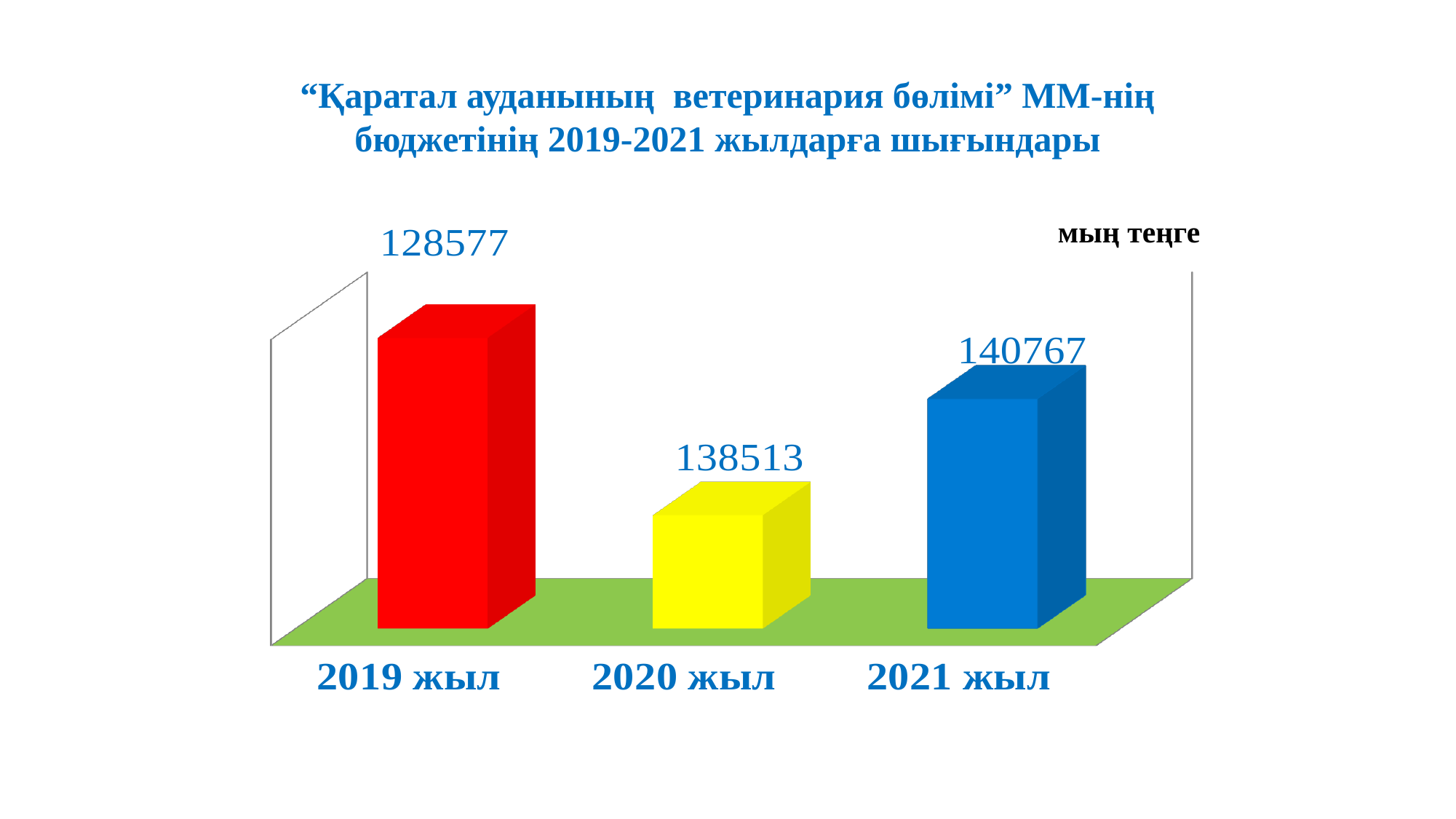
Which year has the highest labelled value? 2021 жыл What unit is indicated in the top right of the chart? мың теңге What is the difference between the values for 2021 жыл and 2019 жыл? 12190 How many categories are shown on the chart? 3 What is the value for 2020 жыл? 138513 What is the value for 2019 жыл? 128577 Which year has the lowest labelled value? 2019 жыл What is the difference between the values for 2021 жыл and 2020 жыл? 2254 What kind of chart is shown on the slide? bar chart What is the value for 2021 жыл? 140767 What is the difference between the values for 2020 жыл and 2019 жыл? 9936 Which labelled value is larger, 2020 жыл or 2021 жыл? 2021 жыл